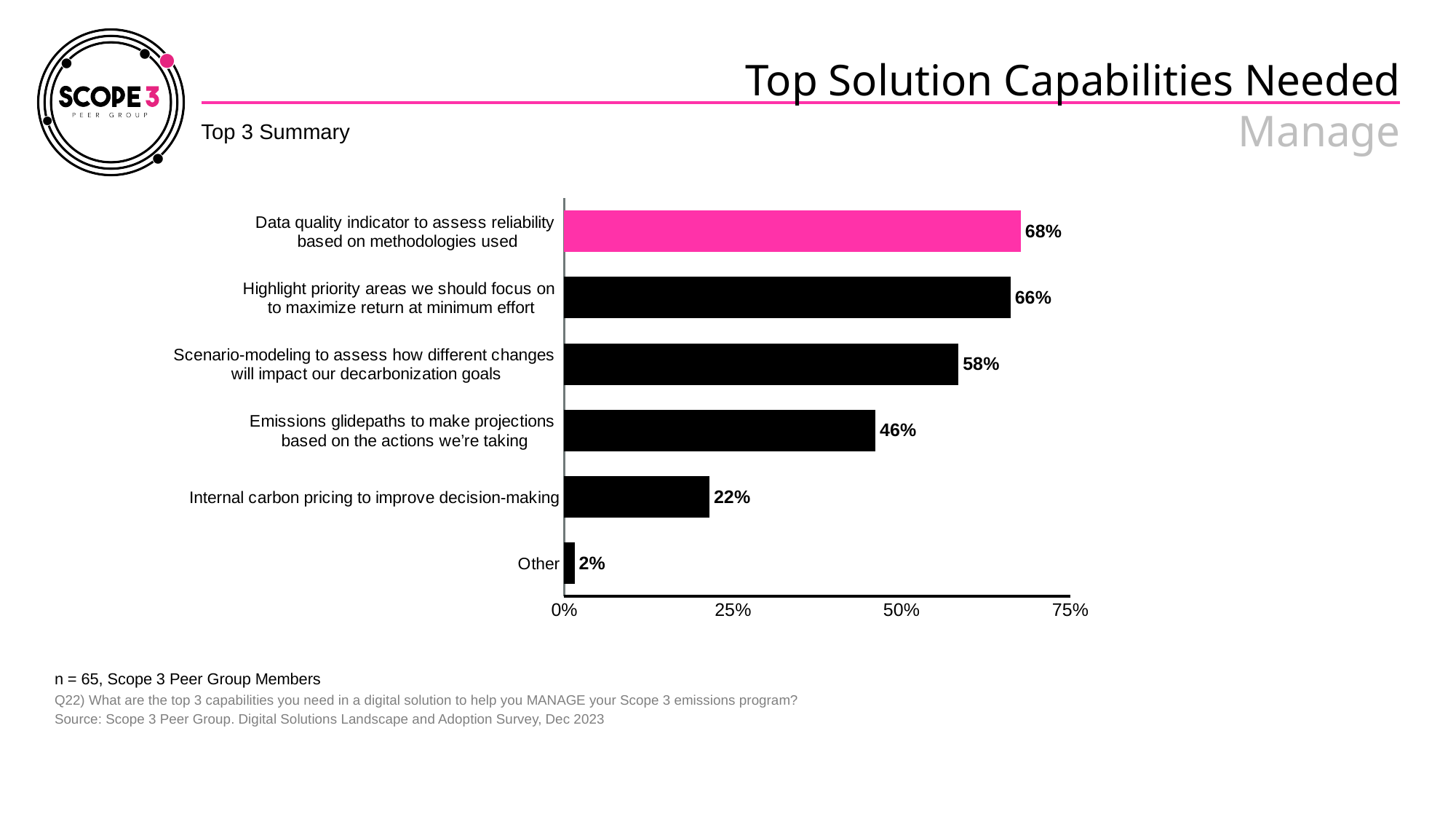
What is the difference between the values for 'Scenario-modeling to assess how different changes will impact our decarbonization goals' and 'Emissions glidepaths to make projections based on the actions we're taking'? 12% What kind of chart is shown on the slide? Bar chart What is the difference between the highest and lowest values in the chart? 66% Is the value for 'Internal carbon pricing to improve decision-making' greater or less than 25%? less Which category has the lowest percentage? Other Which bar is highlighted in pink? Data quality indicator to assess reliability based on methodologies used How many categories are shown in the chart? 6 What is the value shown for 'Internal carbon pricing to improve decision-making'? 22% What is the value shown for 'Emissions glidepaths to make projections based on the actions we're taking'? 46% What percentage of respondents selected 'Data quality indicator to assess reliability based on methodologies used'? 68% Which capability has the highest percentage? Data quality indicator to assess reliability based on methodologies used Which is larger: the value for 'Highlight priority areas we should focus on to maximize return at minimum effort' or the value for 'Scenario-modeling to assess how different changes will impact our decarbonization goals'? Highlight priority areas we should focus on to maximize return at minimum effort